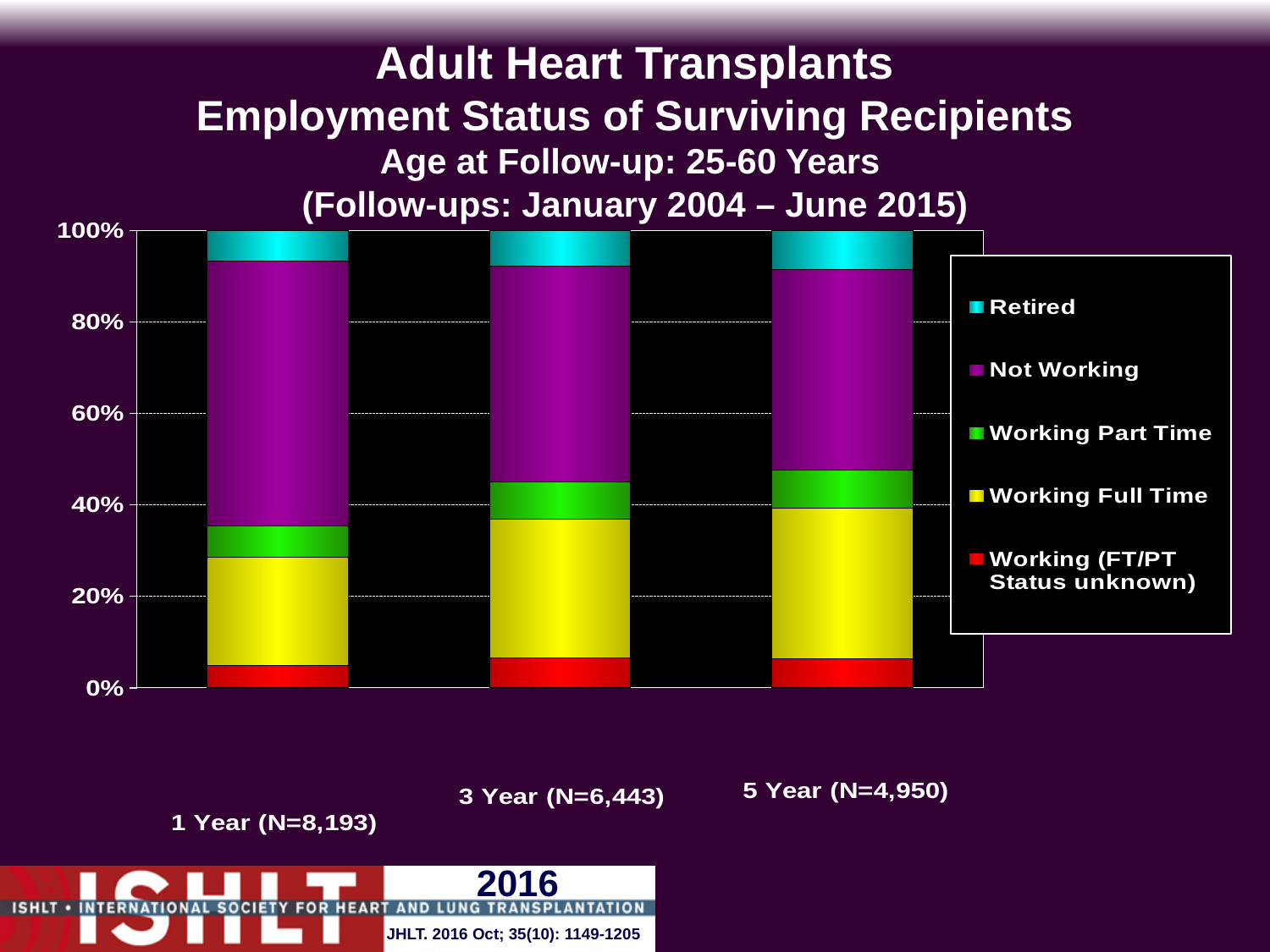
Does the Working Full Time share rise or fall from 1 Year to 5 Year? rise What is the sample size (N) for the 3 Year follow-up bar? 6,443 How many follow-up time points (bars) are shown on the chart? 3 What kind of chart is shown on the slide? Stacked bar chart How many series does the legend list? 5 What does each stacked bar total? 100% In the 1 Year bar, is the Not Working segment greater or less than 40%? greater Which legend entry is shown in purple? Not Working Is the Working Full Time segment larger in the 1 Year bar or the 5 Year bar? 5 Year In the 1 Year bar, is the Retired segment greater or less than 20%? less Which employment status makes up the largest segment of the 1 Year bar? Not Working What is the sample size (N) for the 5 Year follow-up bar? 4,950